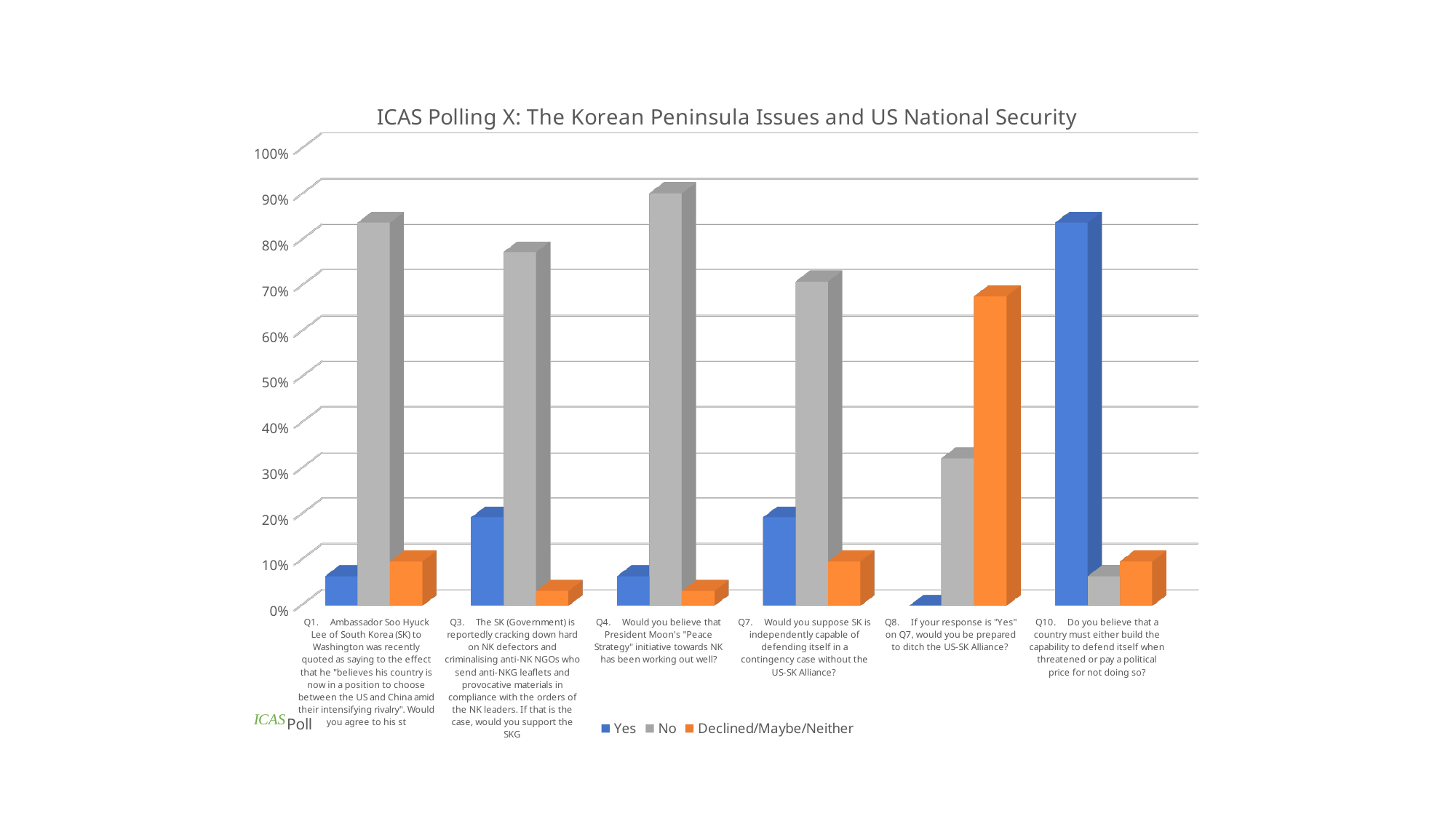
Which poll question has the tallest "No" bar? Q4 Is the "Yes" value for Q10 greater or less than 70%? greater What is the title of the chart? ICAS Polling X: The Korean Peninsula Issues and US National Security Is the "Declined/Maybe/Neither" value for Q8 greater or less than 60%? greater For Q8, which is larger: the "No" bar or the "Declined/Maybe/Neither" bar? Declined/Maybe/Neither Which poll question has the tallest "Declined/Maybe/Neither" bar? Q8 How many poll questions (categories) are plotted on the x axis? 6 How many series does the legend list? 3 Which poll question has the tallest "Yes" bar? Q10 Which poll question has the lowest "Yes" bar? Q8 Is the "No" value for Q4 greater or less than 80%? greater What kind of chart is shown on the slide? bar chart